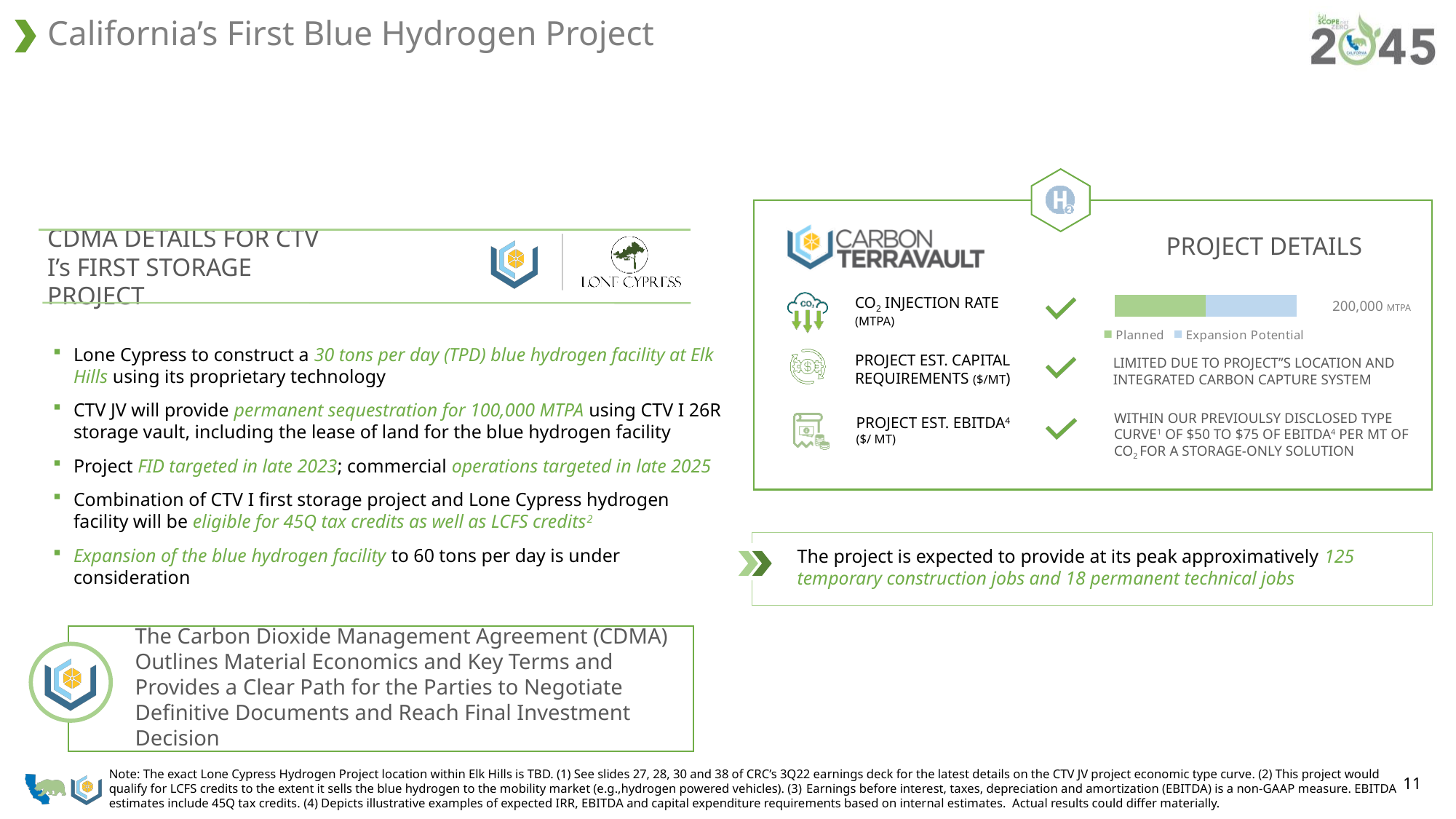
How many series does the legend of the CO2 injection rate bar chart list? 2 How many bars are plotted in the CO2 injection rate bar chart? 1 What total value is labelled at the end of the CO2 injection rate stacked bar? 200,000 MTPA What are the two legend entries of the CO2 injection rate bar chart? Planned and Expansion Potential In what unit is the CO2 injection rate bar chart expressed? MTPA What kind of chart is shown in the Project Details panel next to CO2 Injection Rate? bar chart Which colour represents the Planned series in the CO2 injection rate bar chart? green